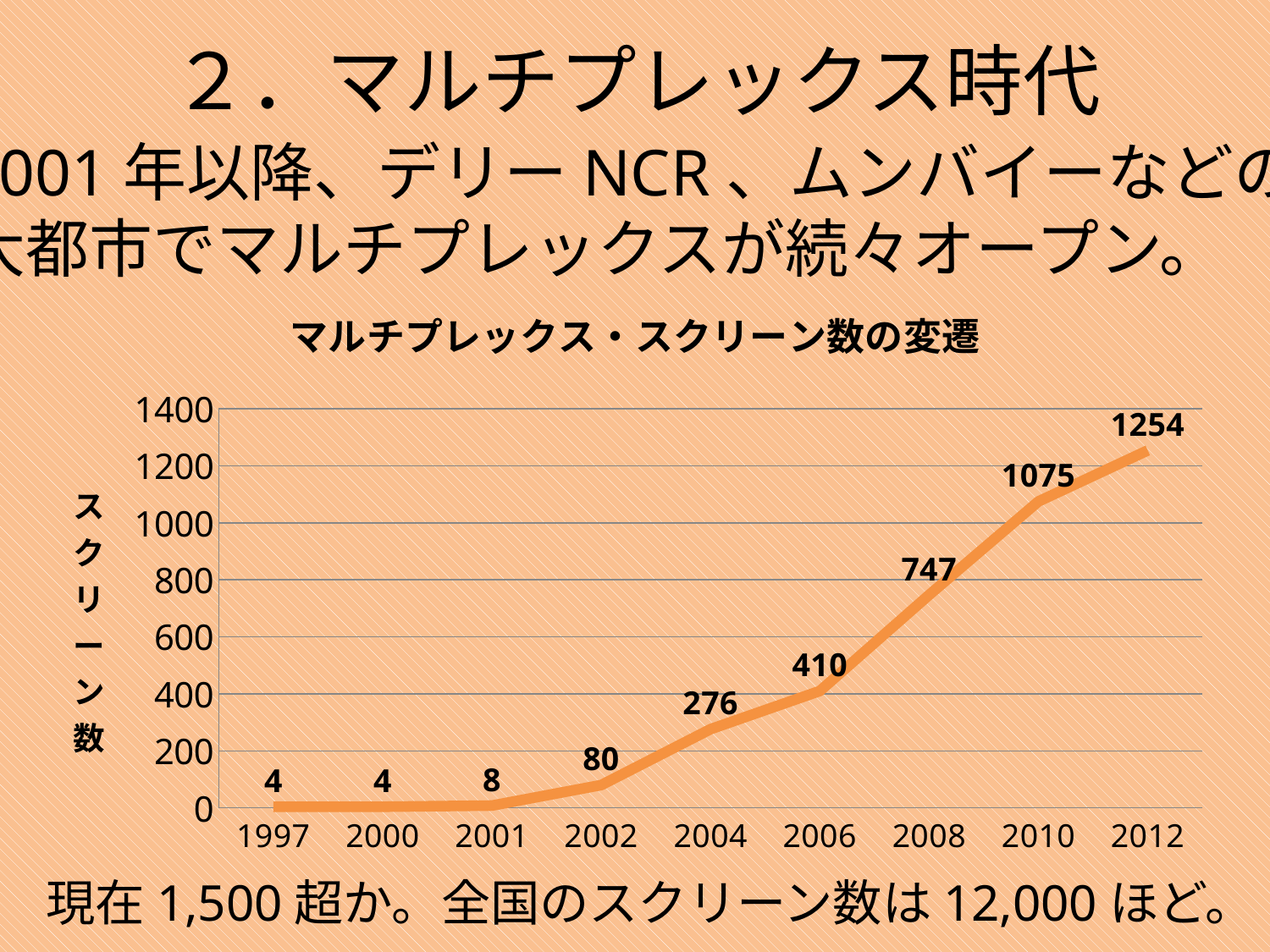
Which year has more multiplex screens, 2006 or 2008? 2008 What is the lowest value shown on the chart? 4 How many years are plotted on the x axis? 9 What kind of chart is shown on the slide? Line chart What is the difference in screen count between 2006 and 2004? 134 What is the difference in screen count between 2012 and 2010? 179 What is the title of the chart? マルチプレックス・スクリーン数の変遷 Do the values rise or fall from 1997 to 2012? Rise What is the number of multiplex screens in 2008? 747 Which year has the highest number of multiplex screens? 2012 What is the number of multiplex screens in 2002? 80 What is the number of multiplex screens in 2012? 1254